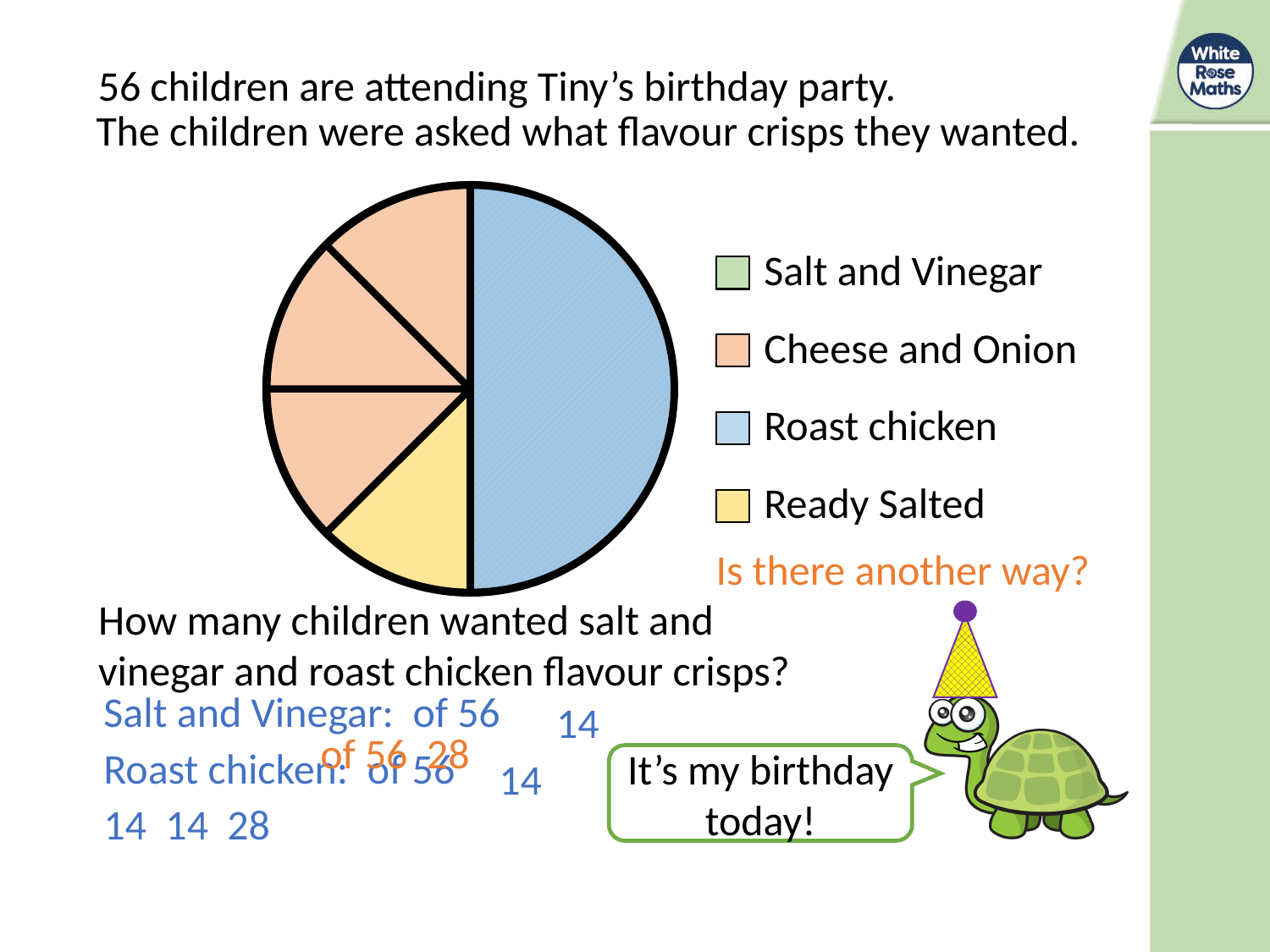
What colour represents Roast chicken in the pie chart legend? blue Which crisp flavour has the largest slice of the pie chart? Roast chicken How many flavours does the legend of the pie chart list? 4 What kind of chart is shown on the slide? pie chart What colour represents Ready Salted in the pie chart legend? yellow How many children in total were asked what flavour crisps they wanted? 56 Which has the larger slice of the pie chart, Cheese and Onion or Ready Salted? Cheese and Onion Which has the larger slice of the pie chart, Roast chicken or Cheese and Onion? Roast chicken Which has the larger slice of the pie chart, Roast chicken or Ready Salted? Roast chicken